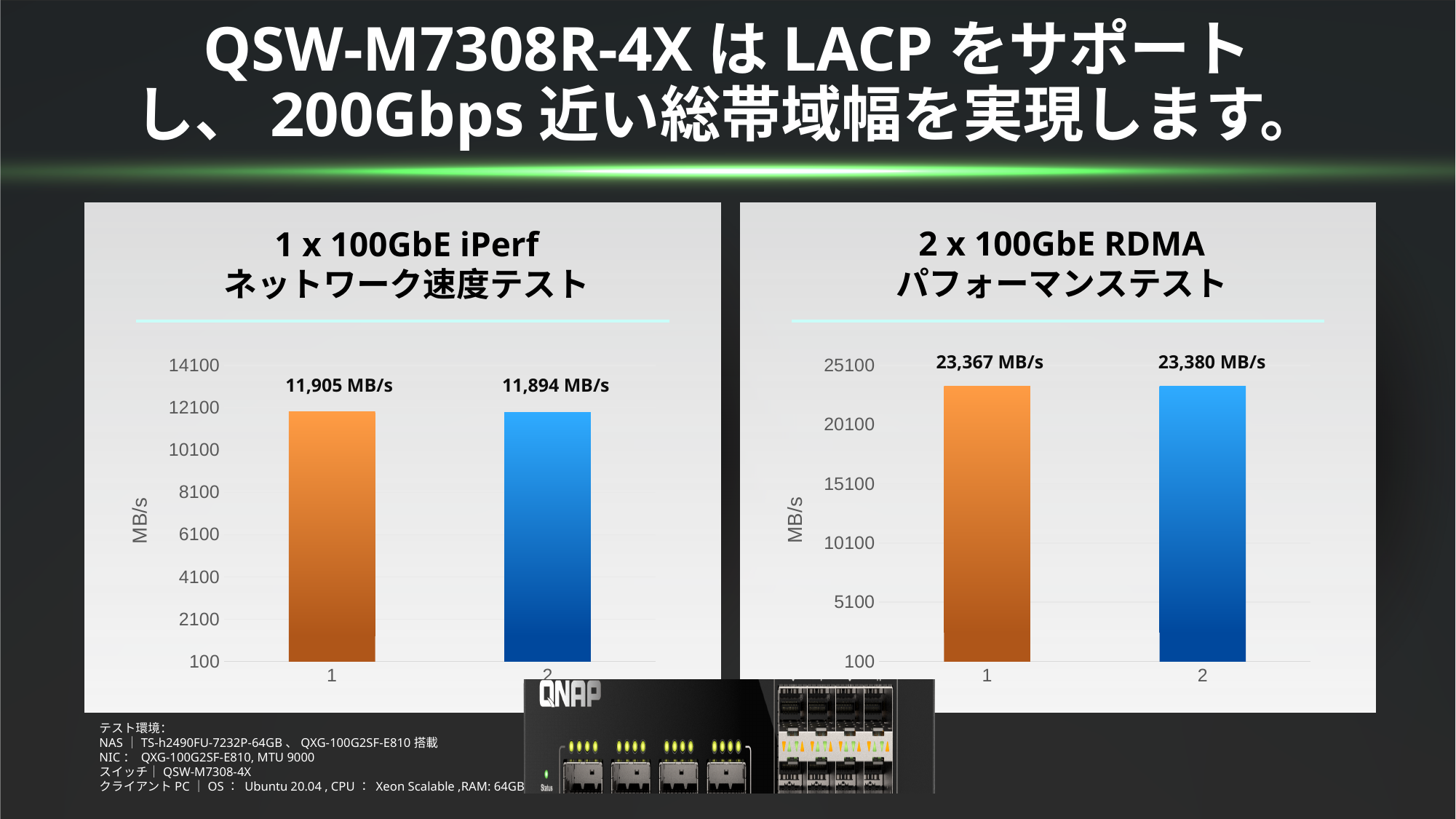
In the 2 x 100GbE RDMA chart on the right, is the value for category 2 greater or less than 20100? greater In the 1 x 100GbE iPerf chart on the left, is the value for category 1 greater or less than 10100? greater In the 1 x 100GbE iPerf chart on the left, what is the difference between the values for category 1 and category 2? 11 MB/s In the 2 x 100GbE RDMA chart on the right, what is the value for category 2? 23,380 MB/s How many bars are plotted in the 1 x 100GbE iPerf chart on the left? 2 What type of chart is the 2 x 100GbE RDMA chart on the right? Bar chart What unit is shown on the y axis of the chart on the left? MB/s In the 2 x 100GbE RDMA chart on the right, what is the value for category 1? 23,367 MB/s In the 1 x 100GbE iPerf chart on the left, what is the value for category 2? 11,894 MB/s In the 1 x 100GbE iPerf chart on the left, what is the value for category 1? 11,905 MB/s In the 2 x 100GbE RDMA chart on the right, which category has the higher labelled value, 1 or 2? 2 In the 2 x 100GbE RDMA chart on the right, what is the difference between the values for category 2 and category 1? 13 MB/s